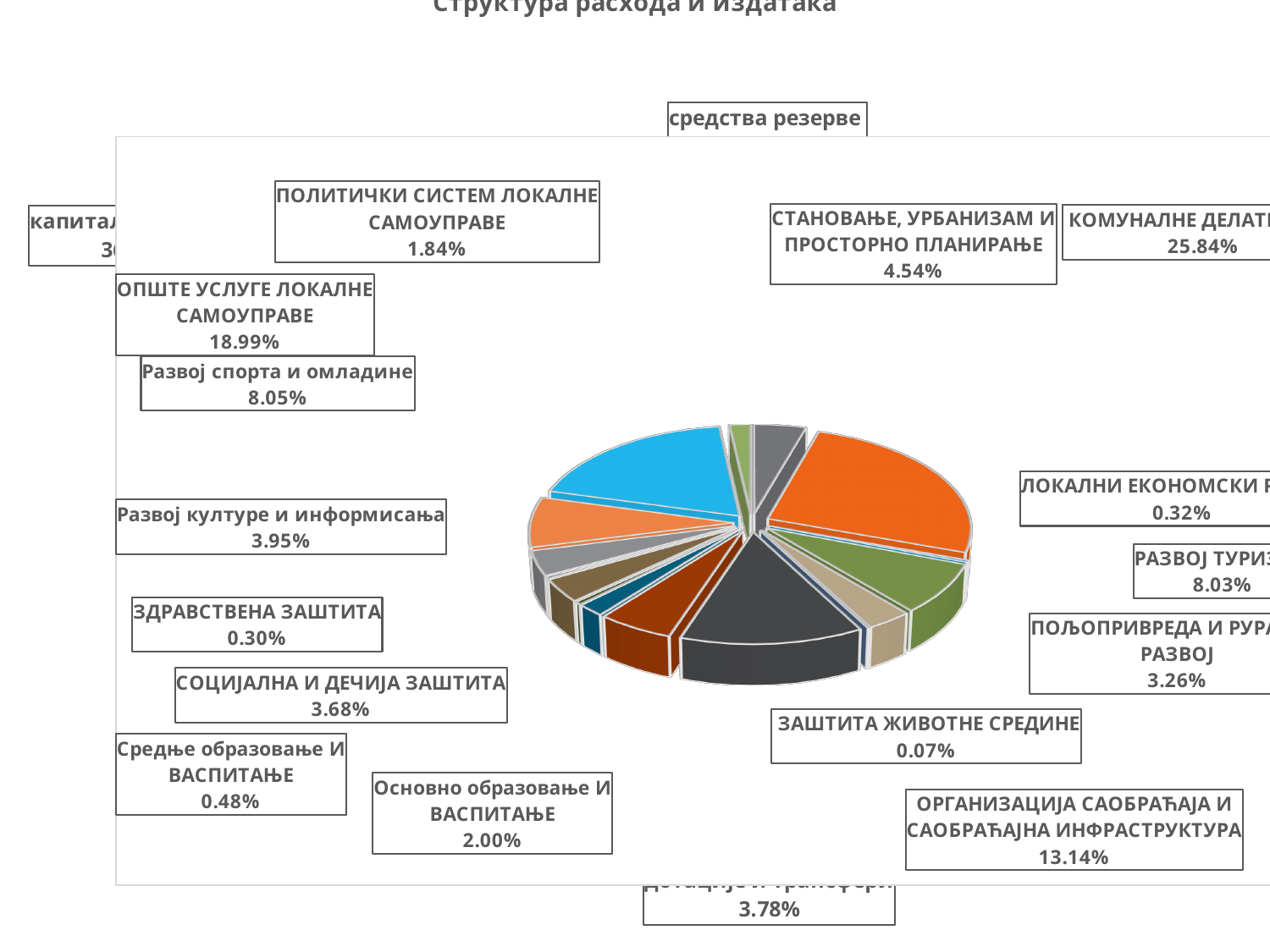
What is the difference in percentage points between Средње образовање И ВАСПИТАЊЕ and ЗДРАВСТВЕНА ЗАШТИТА? 0.18% What share does ОПШТЕ УСЛУГЕ ЛОКАЛНЕ САМОУПРАВЕ have in the pie chart? 18.99% What is the difference in percentage points between ОПШТЕ УСЛУГЕ ЛОКАЛНЕ САМОУПРАВЕ and ОРГАНИЗАЦИЈА САОБРАЋАЈА И САОБРАЋАЈНА ИНФРАСТРУКТУРА? 5.85% What percentage is shown for ПОЛИТИЧКИ СИСТЕМ ЛОКАЛНЕ САМОУПРАВЕ? 1.84% What percentage is shown for Развој спорта и омладине? 8.05% What percentage is shown for ЗАШТИТА ЖИВОТНЕ СРЕДИНЕ? 0.07% Which has a larger share, СОЦИЈАЛНА И ДЕЧИЈА ЗАШТИТА or ЗДРАВСТВЕНА ЗАШТИТА? СОЦИЈАЛНА И ДЕЧИЈА ЗАШТИТА What percentage is shown for ОРГАНИЗАЦИЈА САОБРАЋАЈА И САОБРАЋАЈНА ИНФРАСТРУКТУРА? 13.14% What kind of chart is shown on the slide? pie chart What percentage is shown for СТАНОВАЊЕ, УРБАНИЗАМ И ПРОСТОРНО ПЛАНИРАЊЕ? 4.54% What percentage is shown for Основно образовање И ВАСПИТАЊЕ? 2.00%